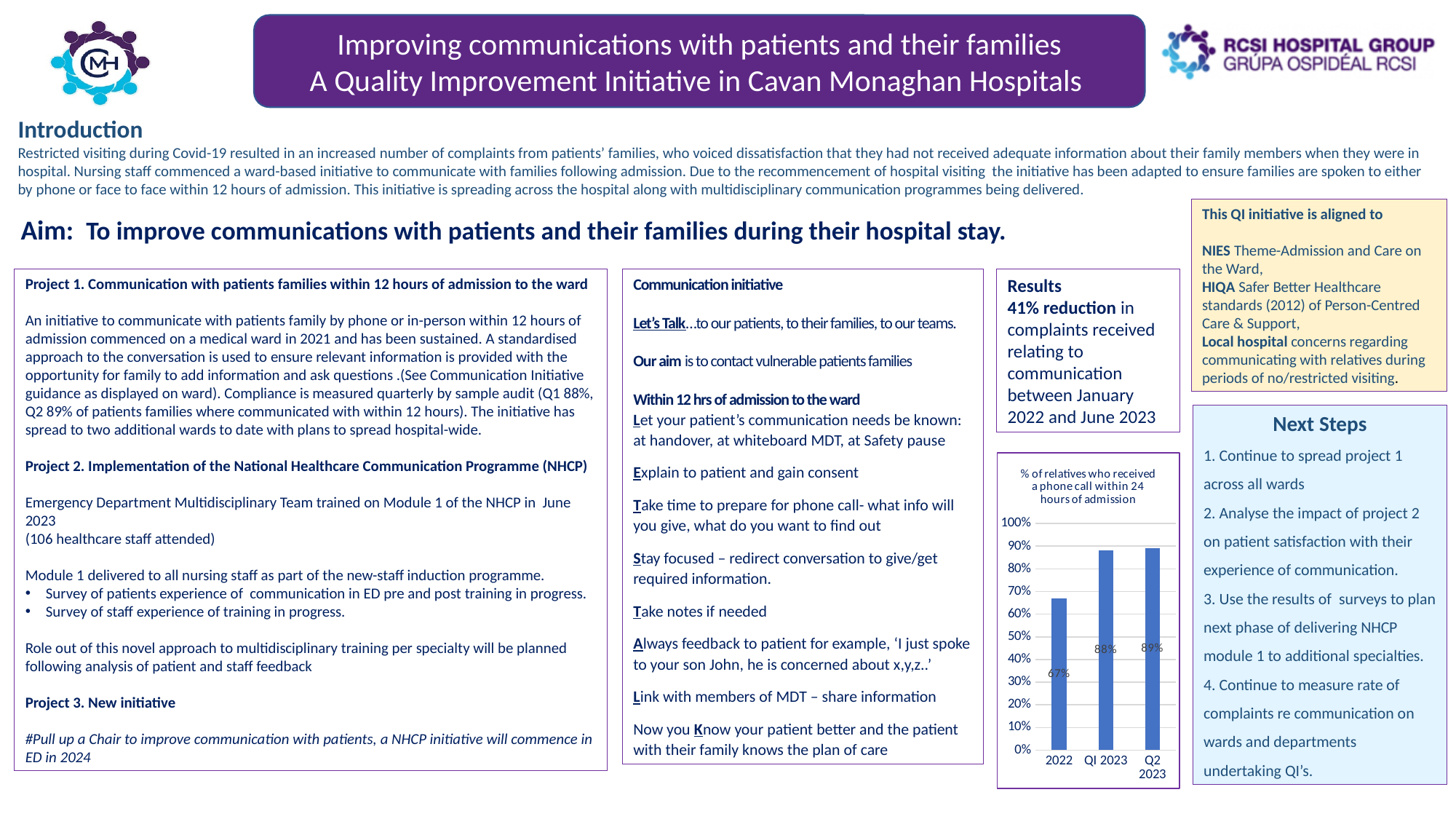
What type of chart is shown on the slide? bar chart What is the difference between the value for QI 2023 and the value for 2022? 21% What is the value for Q2 2023 in the chart? 89% What is the title of the chart on the slide? % of relatives who received a phone call within 24 hours of admission Which category has the lowest value in the chart? 2022 What is the value for 2022 in the chart? 67% How many categories are plotted in the chart? 3 Is the value for 2022 greater or less than 70%? less What is the value for QI 2023 in the chart? 88% Which is larger, the value for 2022 or the value for QI 2023? QI 2023 Do the values rise or fall from 2022 to Q2 2023 in the chart? rise Which category has the highest value in the chart? Q2 2023